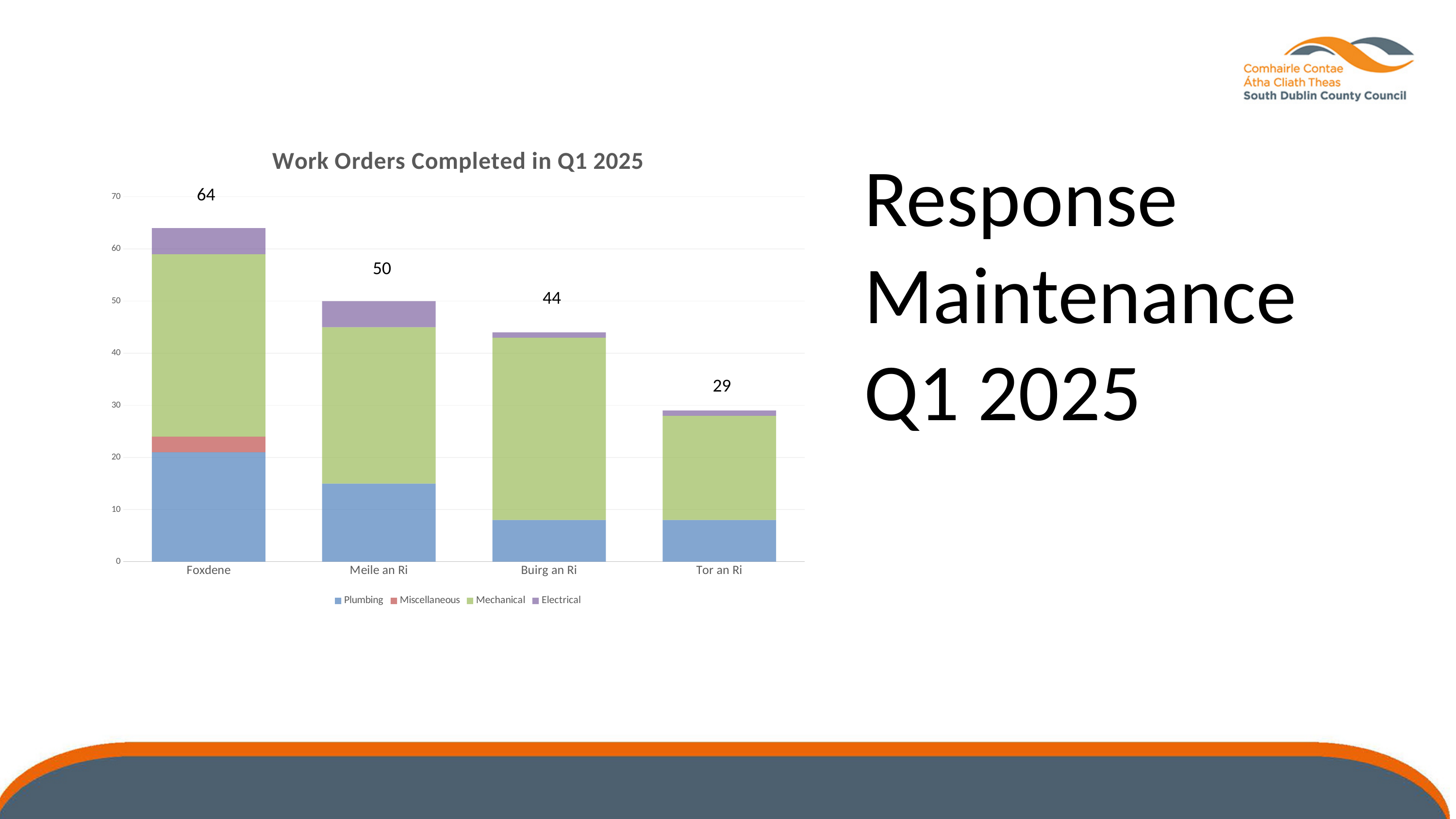
What is the total number of work orders completed for Tor an Ri? 29 What is the total number of work orders completed for Foxdene? 64 How many locations are shown on the x axis? 4 What is the difference between the totals for Foxdene and Tor an Ri? 35 How many series does the legend list? 4 What is the title of the chart? Work Orders Completed in Q1 2025 Which has a larger total of work orders, Meile an Ri or Buirg an Ri? Meile an Ri Is the Plumbing value for Tor an Ri greater or less than 10? less Which location has the highest total of work orders completed? Foxdene Which location has the lowest total of work orders completed? Tor an Ri Do the total work orders rise or fall from Foxdene to Tor an Ri along the x axis? Fall What kind of chart is shown on the slide? Stacked bar chart